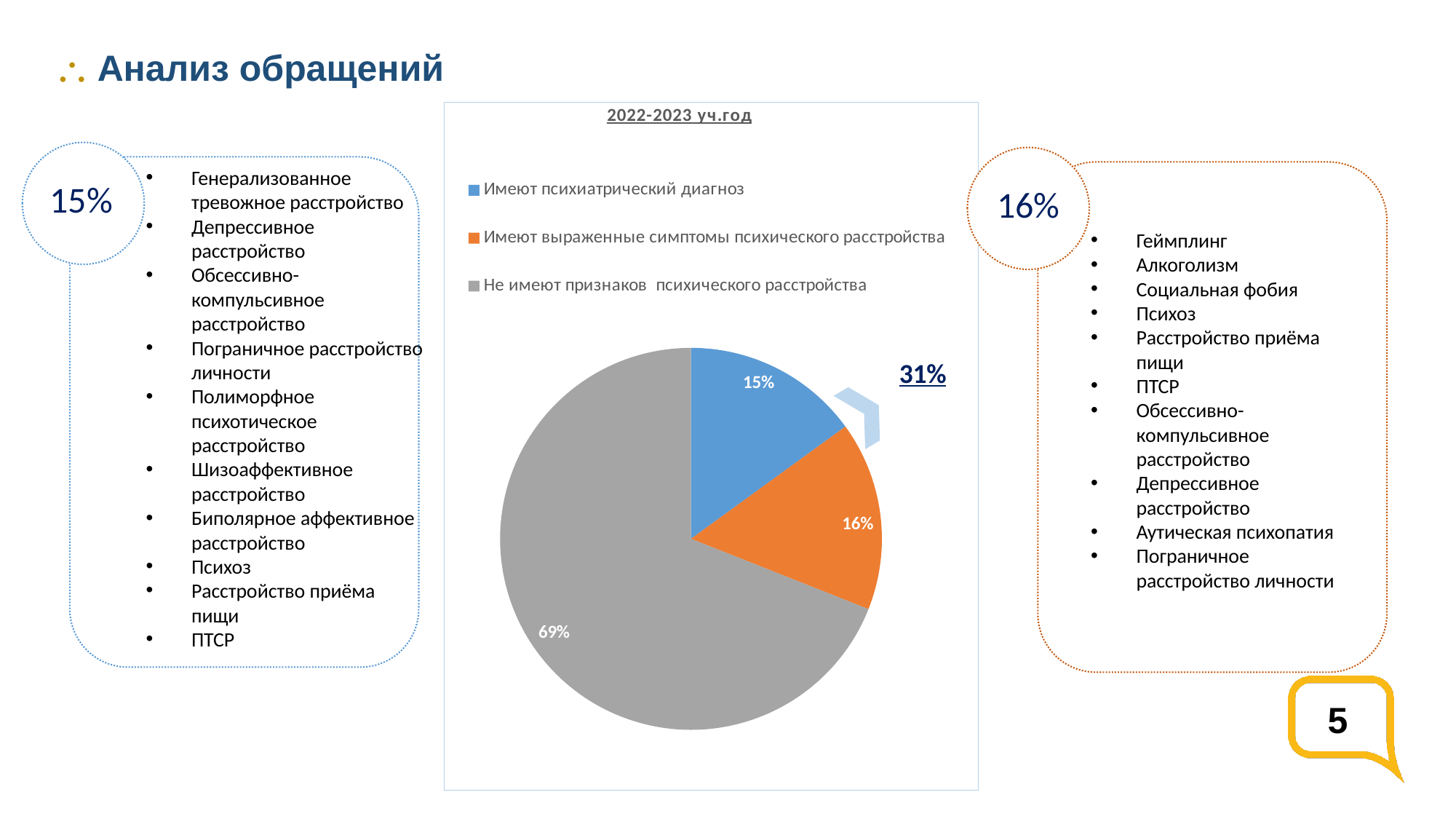
Which category has the largest slice of the pie? Не имеют признаков психического расстройства What percentage of the pie is labelled "Имеют выраженные симптомы психического расстройства"? 16% What is the title of the chart? 2022-2023 уч.год What is the combined share of the "Имеют психиатрический диагноз" and "Имеют выраженные симптомы психического расстройства" slices? 31% How many entries does the legend list? 3 How many slices does the pie chart have? 3 What type of chart is shown on the slide? pie chart What is the difference between the "Не имеют признаков психического расстройства" slice and the "Имеют выраженные симптомы психического расстройства" slice? 53% What colour is the slice for "Имеют выраженные симптомы психического расстройства"? orange Which category has the smallest slice of the pie? Имеют психиатрический диагноз What percentage of the pie is labelled "Имеют психиатрический диагноз"? 15% What percentage of the pie is labelled "Не имеют признаков психического расстройства"? 69%